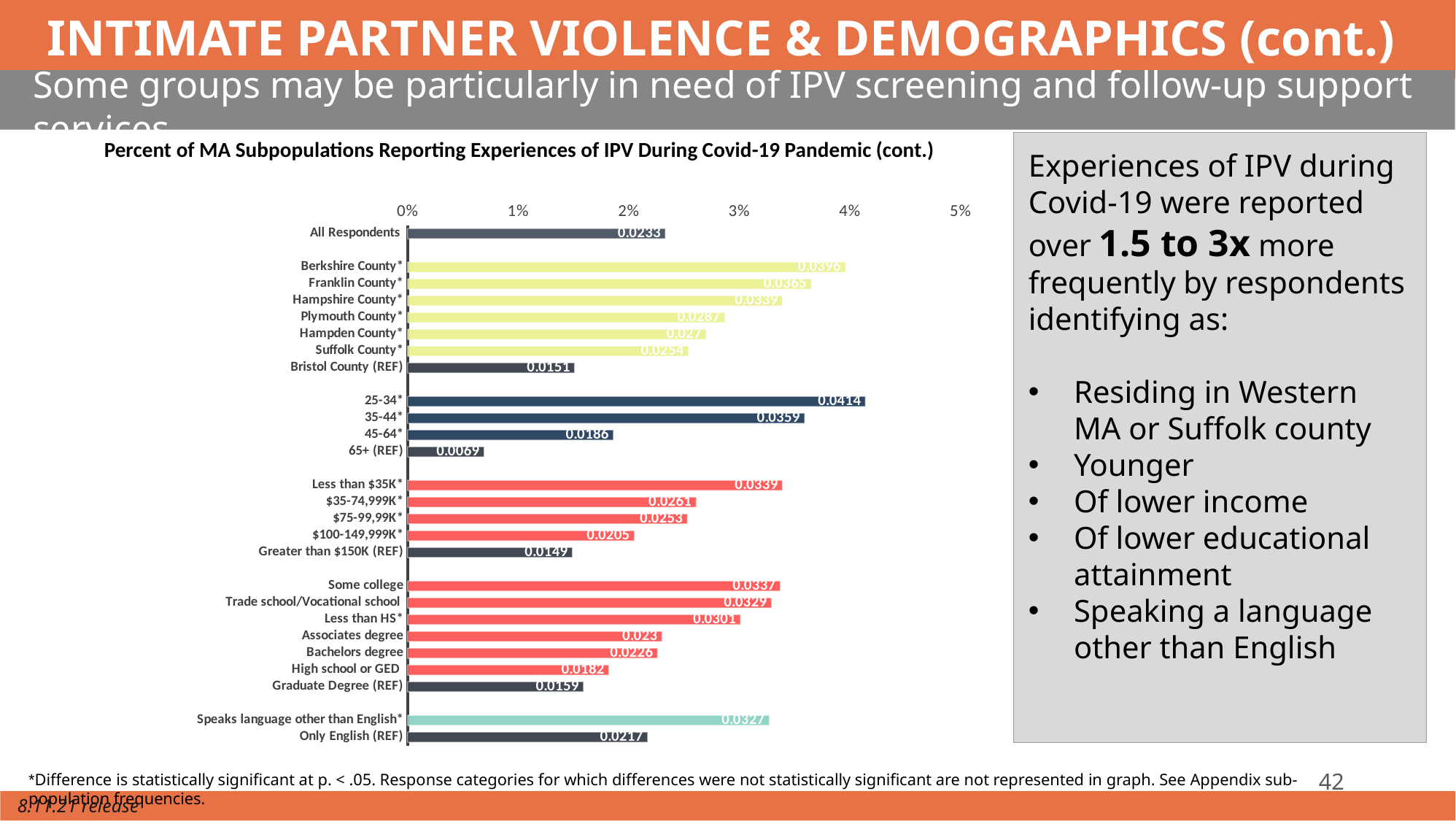
What is the title of the chart? Percent of MA Subpopulations Reporting Experiences of IPV During Covid-19 Pandemic (cont.) What kind of chart is shown on the slide? bar chart What is the value shown for Speaks language other than English*? 0.0327 What is the difference between the values for Berkshire County* and Bristol County (REF)? 0.0245 What is the value shown for All Respondents? 0.0233 How many categories (bars) are plotted in the chart? 26 Which has a larger value, Franklin County* or Hampshire County*? Franklin County* Which category has the highest value in the chart? 25-34* Is the value for Bristol County (REF) greater or less than 2%? less What is the value shown for Berkshire County*? 0.0396 What is the value shown for Less than $35K*? 0.0339 Which category has the lowest value in the chart? 65+ (REF)